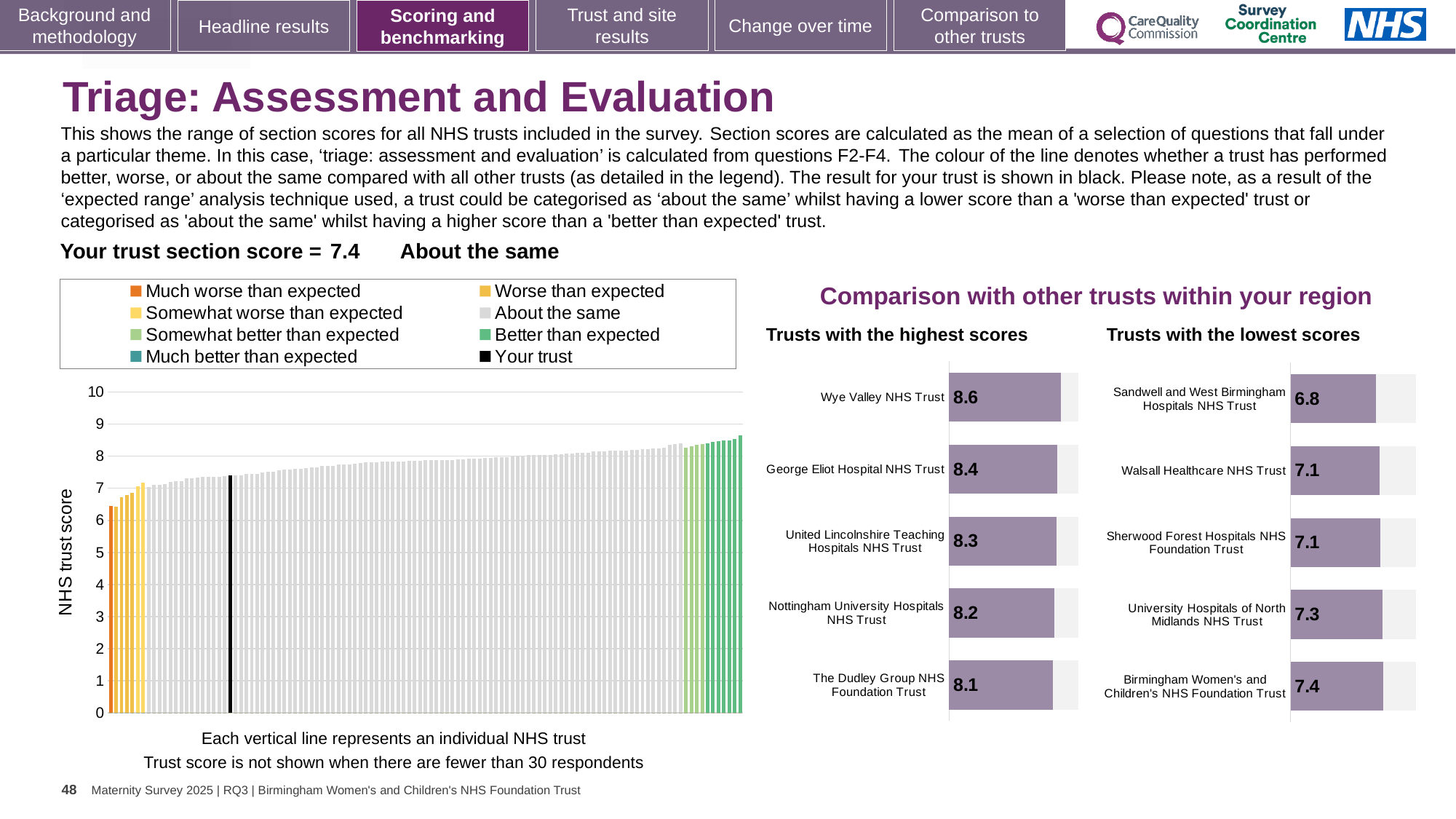
What kind of chart is the main chart on the left showing NHS trust scores? bar chart How many entries does the legend above the main chart on the left list? 8 In the main chart on the left, do the trust scores rise or fall from left to right? rise In the 'Trusts with the highest scores' chart, which trust has the highest score? Wye Valley NHS Trust In the 'Trusts with the highest scores' chart, how many trusts are shown? 5 In the 'Trusts with the highest scores' chart, what is the score for Wye Valley NHS Trust? 8.6 In the main chart on the left showing NHS trust scores, is the value of the black bar (your trust) greater or less than 7? greater In the 'Trusts with the lowest scores' chart, what is the score for Sandwell and West Birmingham Hospitals NHS Trust? 6.8 In the 'Trusts with the highest scores' chart, what is the difference between the scores of Wye Valley NHS Trust and The Dudley Group NHS Foundation Trust? 0.5 In the 'Trusts with the lowest scores' chart, which trust has the lowest score? Sandwell and West Birmingham Hospitals NHS Trust In the 'Trusts with the lowest scores' chart, what is the score for Birmingham Women's and Children's NHS Foundation Trust? 7.4 In the 'Trusts with the lowest scores' chart, which has the larger score: Walsall Healthcare NHS Trust or University Hospitals of North Midlands NHS Trust? University Hospitals of North Midlands NHS Trust